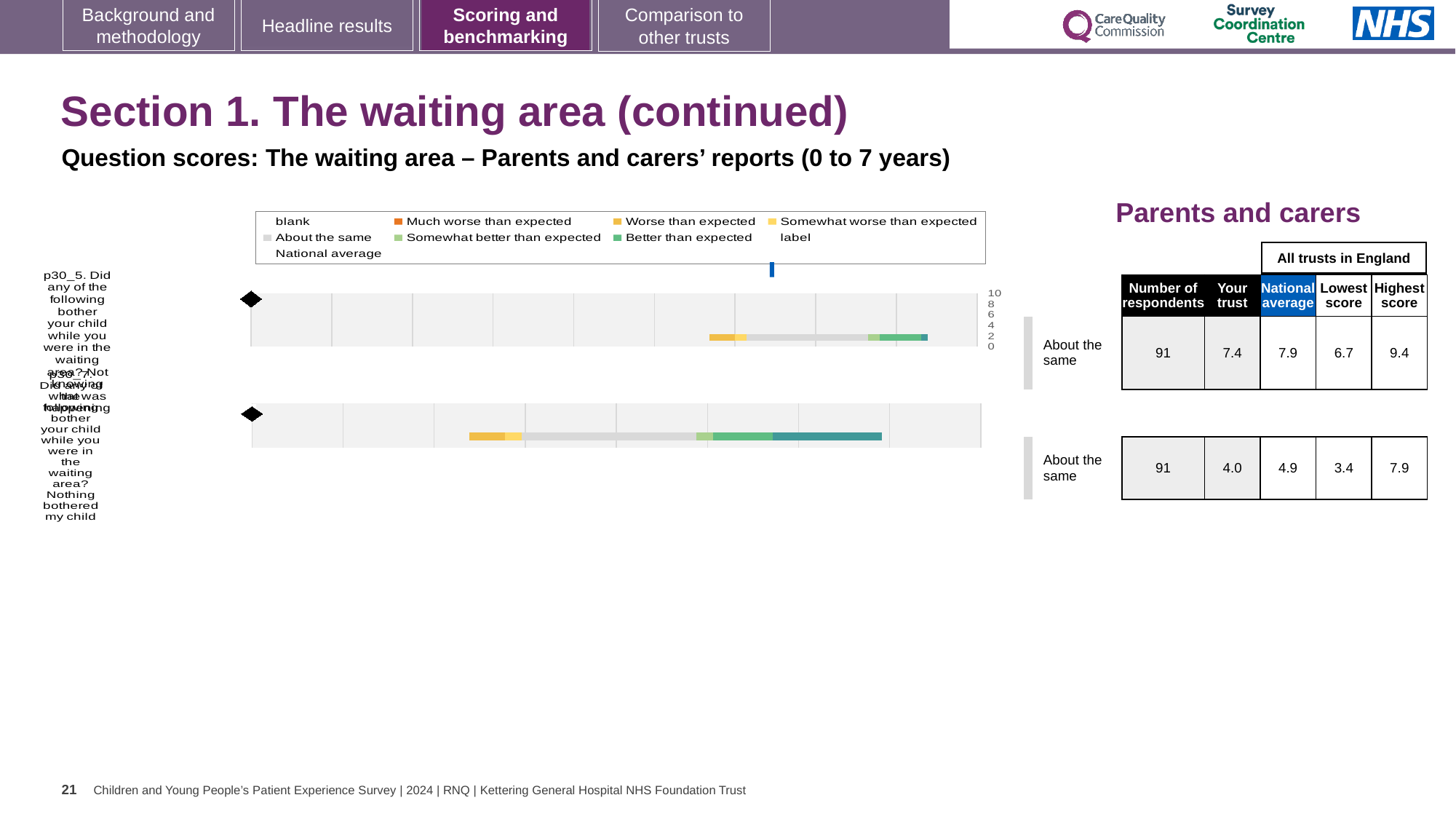
What is the difference between the national average and the 'Your trust' score for the top bar (question p30_5)? 0.5 For the bottom bar (question p30_7), which is larger: the 'Your trust' score or the national average? National average How many bars (questions) are plotted in the chart? 2 What is the 'Your trust' score for the bottom bar (question p30_7, Nothing bothered my child)? 4.0 How many respondents answered question p30_7 (bottom bar)? 91 What kind of chart is shown on the slide? bar chart What is the lowest score among all trusts in England for the bottom bar (question p30_7)? 3.4 What is the 'Your trust' score for the top bar (question p30_5, Not knowing what was happening)? 7.4 What is the highest score among all trusts in England for the top bar (question p30_5)? 9.4 How many entries does the chart legend list? 9 What is the national average score for the top bar (question p30_5)? 7.9 What is the highest value shown on the chart's score axis? 10